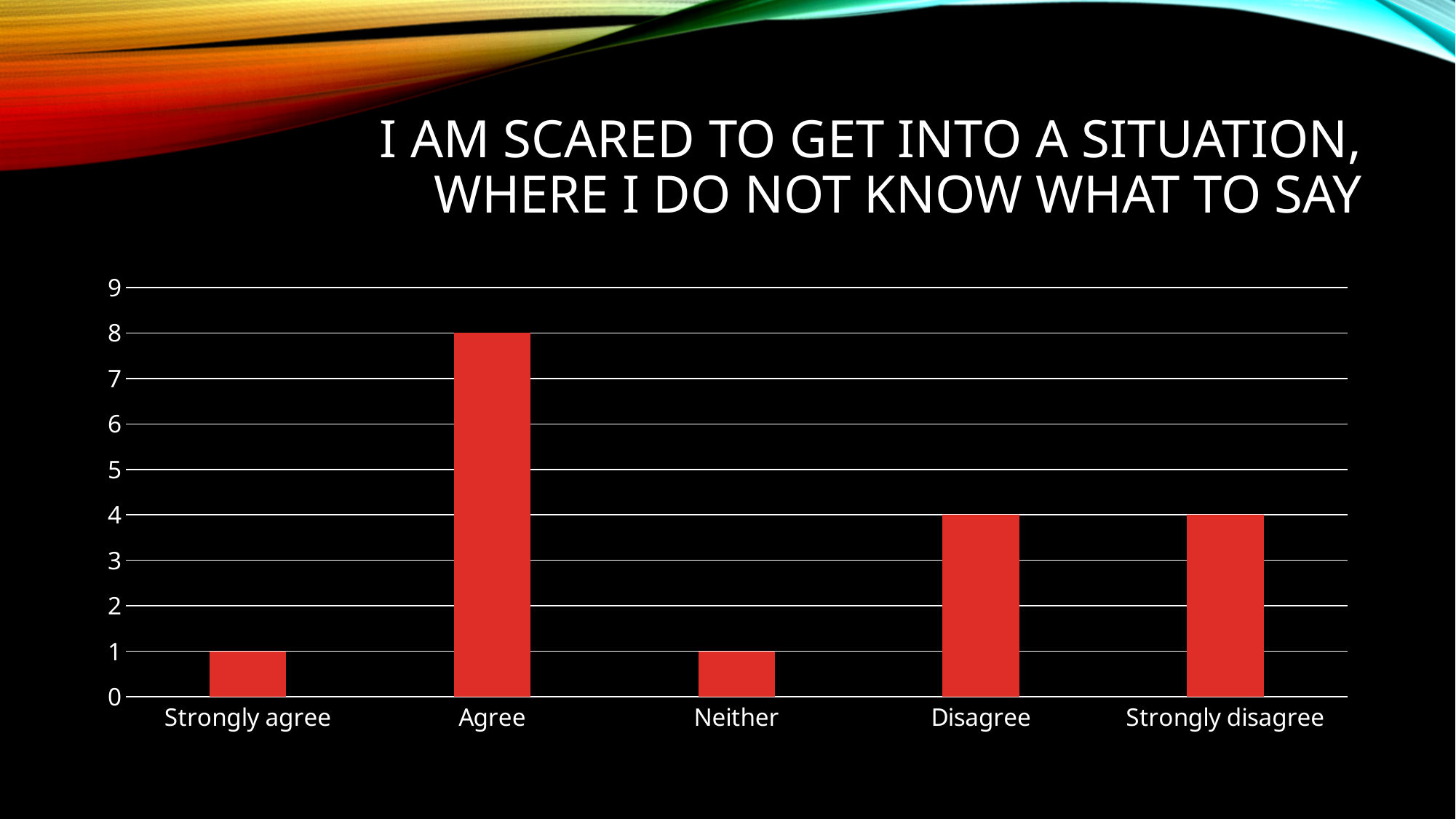
Which category has the highest value? Agree What is the difference between the values for Strongly disagree and Neither? 3 What is the value for Strongly disagree? 4 What is the difference between the values for Agree and Disagree? 4 What is the value for Agree? 8 How many categories are shown on the x axis? 5 What is the value for Neither? 1 Which is larger, the value for Agree or the value for Strongly disagree? Agree What is the value for Disagree? 4 What kind of chart is shown on the slide? bar chart What is the value for Strongly agree? 1 Is the value for Agree greater or less than 5? greater